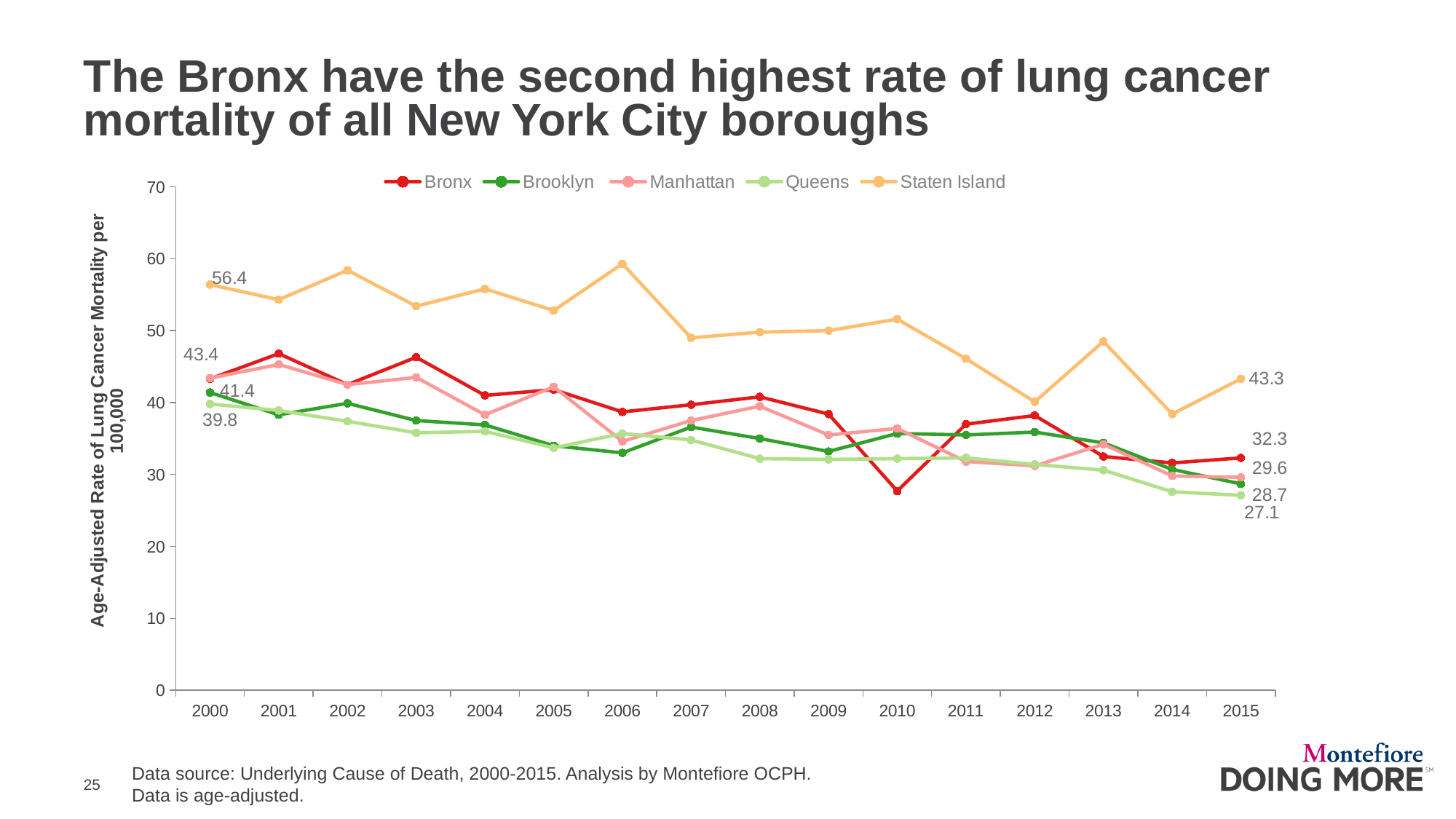
What kind of chart is shown on the slide? Line chart What is the value for the Bronx in 2015? 32.3 What is the value for Brooklyn in 2000? 41.4 Which borough has the lowest lung cancer mortality rate in 2015? Queens What is the value for Staten Island in 2000? 56.4 What is the difference between the Bronx and Queens values in 2015? 5.2 Is the value for the Bronx in 2010 greater or less than 30? less What is the value for Queens in 2015? 27.1 What is the value for Staten Island in 2015? 43.3 By how much did the Staten Island value fall from 2000 to 2015? 13.1 How many series does the legend list? 5 Which borough has the highest lung cancer mortality rate in 2015? Staten Island